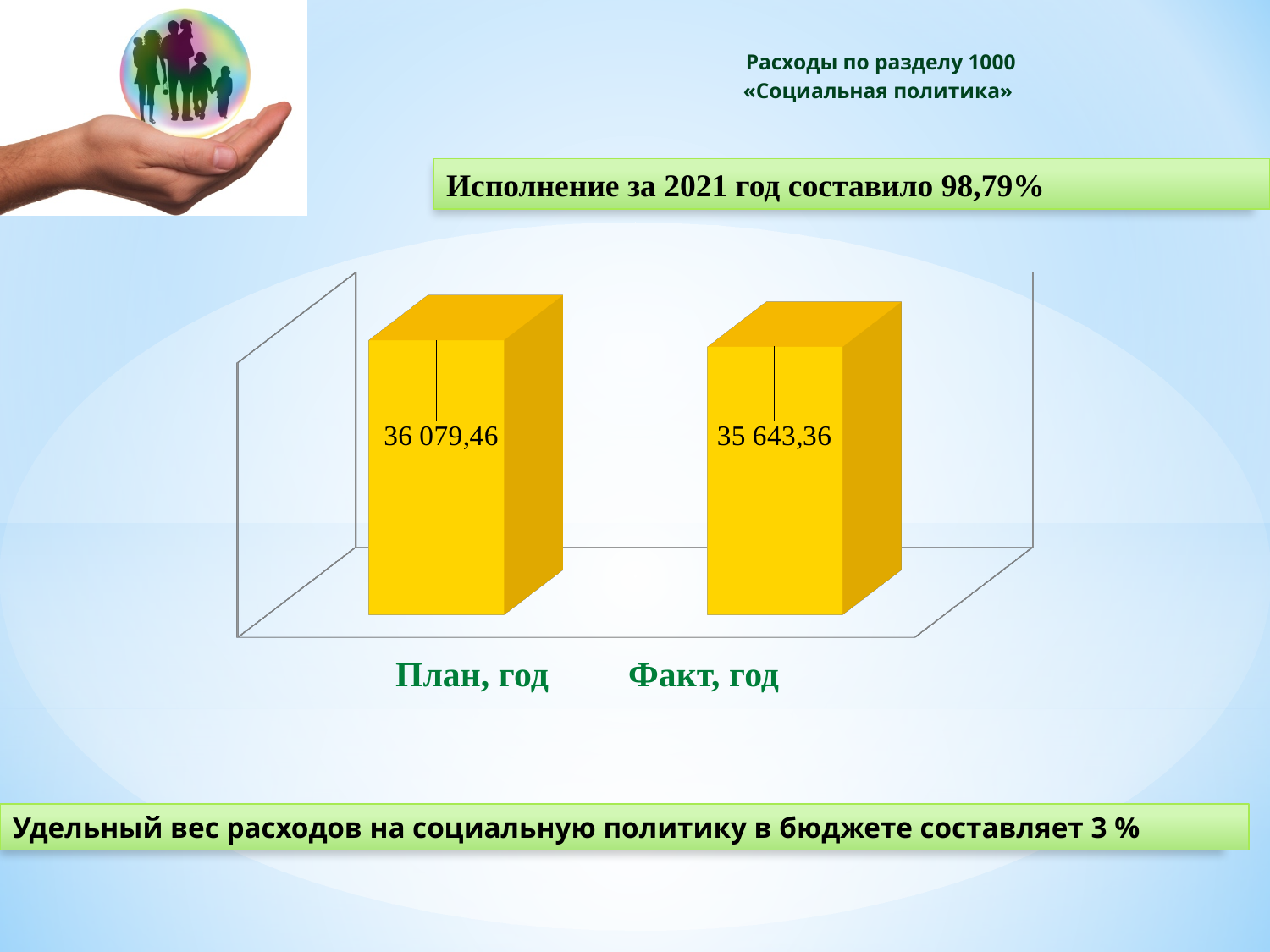
Do the values rise or fall from План, год to Факт, год? fall How many bars are shown in the chart? 2 What colour are the bars in the chart? yellow What kind of chart is shown on the slide? bar chart Is the value for Факт, год larger or smaller than the value for План, год? smaller What is the value for План, год? 36 079,46 What is the difference between the values for План, год and Факт, год? 436,10 What is the value for Факт, год? 35 643,36 Which category has the lower value? Факт, год Which category has the higher value? План, год What are the two category labels on the x axis of the chart? План, год and Факт, год